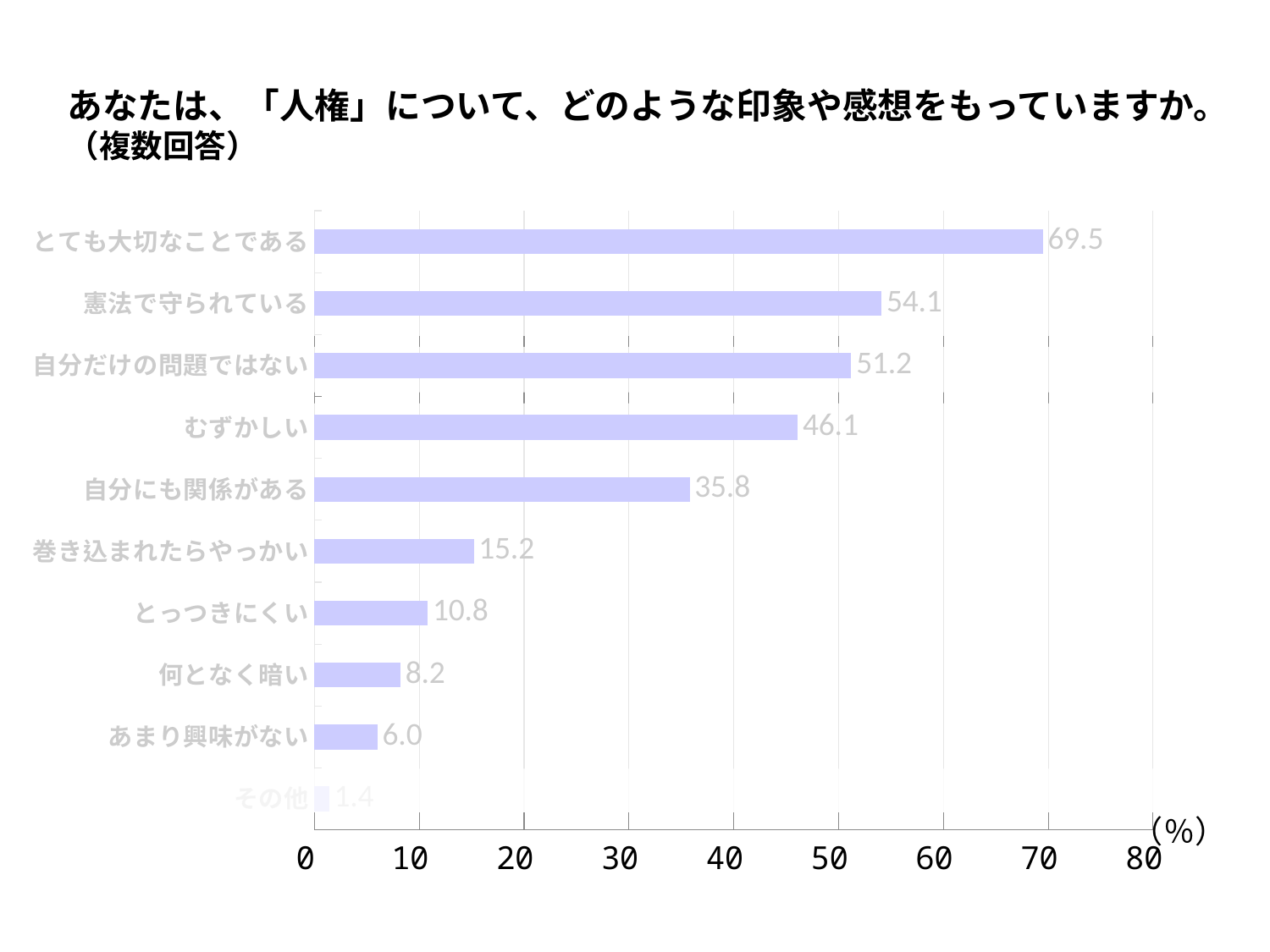
How many categories are shown in the chart? 10 Which is larger, the value for 巻き込まれたらやっかい or the value for とっつきにくい? 巻き込まれたらやっかい What unit is shown at the end of the x axis? (%) What kind of chart is shown on the slide? bar chart What is the difference between the values for とても大切なことである and 何となく暗い? 61.3 What is the value for むずかしい? 46.1 Which category has the lowest value? その他 Is the value for 自分にも関係がある greater or less than 40? less What is the difference between the values for 憲法で守られている and 自分だけの問題ではない? 2.9 What is the value for あまり興味がない? 6.0 What is the value for とても大切なことである? 69.5 Which category has the highest value? とても大切なことである